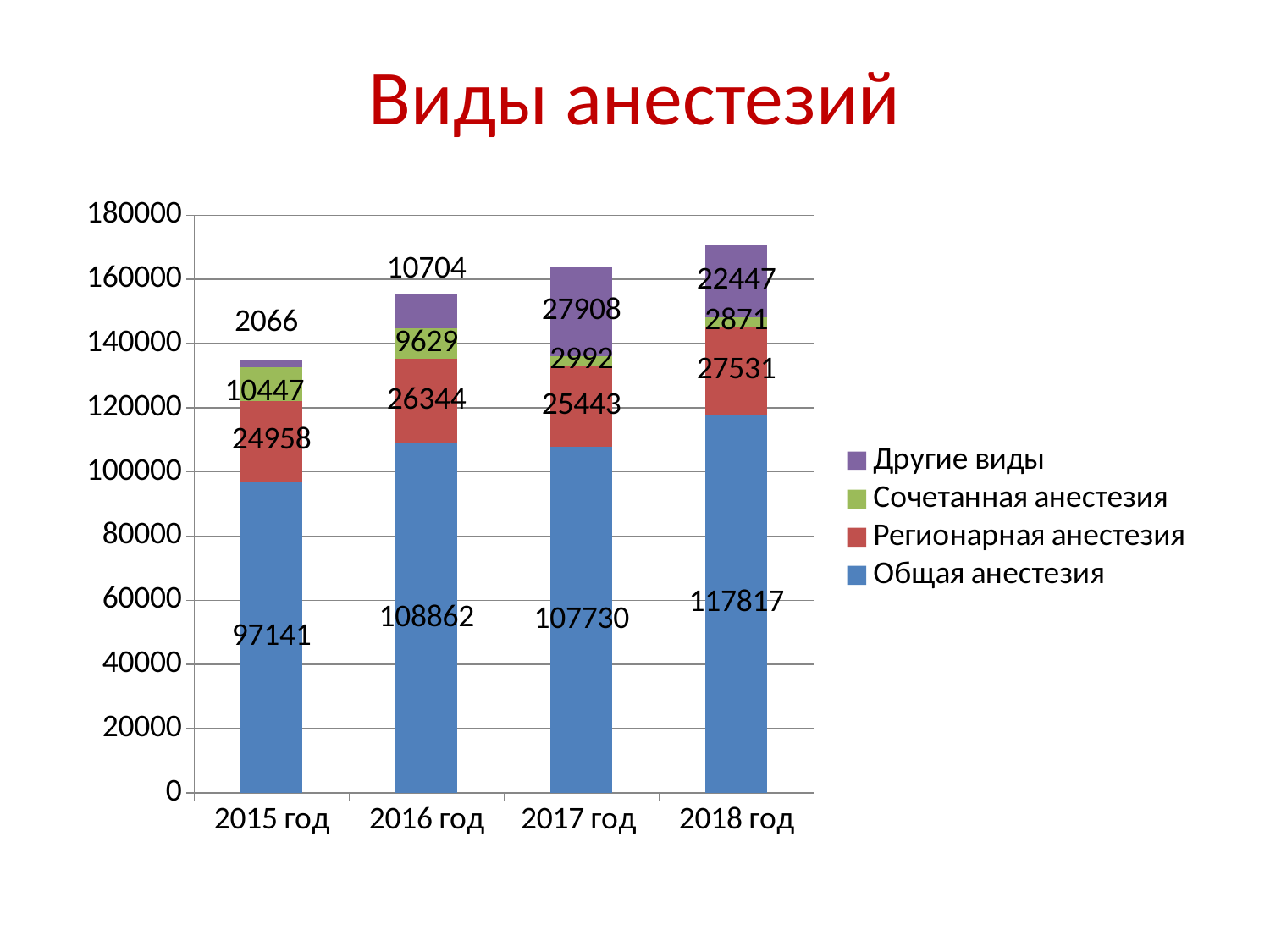
In which year is the value for Общая анестезия the highest? 2018 год What kind of chart is shown on the slide? Stacked bar chart Which year has the larger value for Другие виды, 2016 год or 2017 год? 2017 год How many series does the legend list? 4 What is the value for Общая анестезия in 2018 год? 117817 Does the total height of the stacked bars rise or fall from 2015 год to 2018 год? Rise What is the value for Другие виды in 2017 год? 27908 What is the value for Сочетанная анестезия in 2015 год? 10447 In which year is the value for Сочетанная анестезия the lowest? 2018 год What is the total of the stacked bar for 2015 год? 134612 What is the difference between the Регионарная анестезия values for 2018 год and 2015 год? 2573 How many years are shown on the x axis? 4